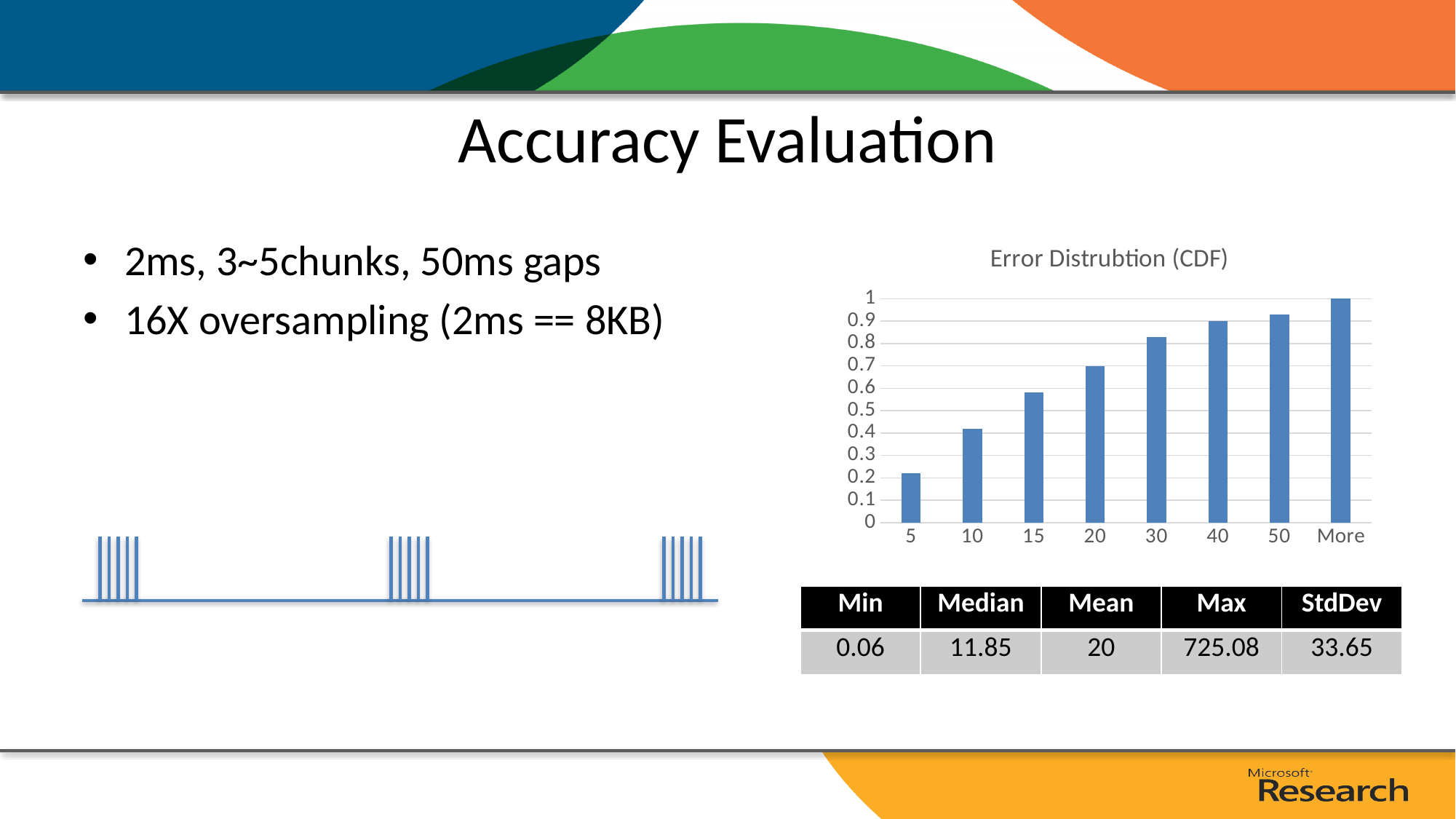
Is the value for category 5 greater or less than 0.3? less Do the values rise or fall as you move from left to right along the x axis? rise Is the value for category 20 greater or less than 0.8? less Is the value for category 10 greater or less than 0.3? greater Which category has the highest value in the chart? More How many categories are shown on the x axis of the chart? 8 Which category has the lowest value in the chart? 5 What kind of chart is shown on the slide? bar chart Which has the larger value, category 20 or category 10? 20 What is the title of the chart? Error Distrubtion (CDF)